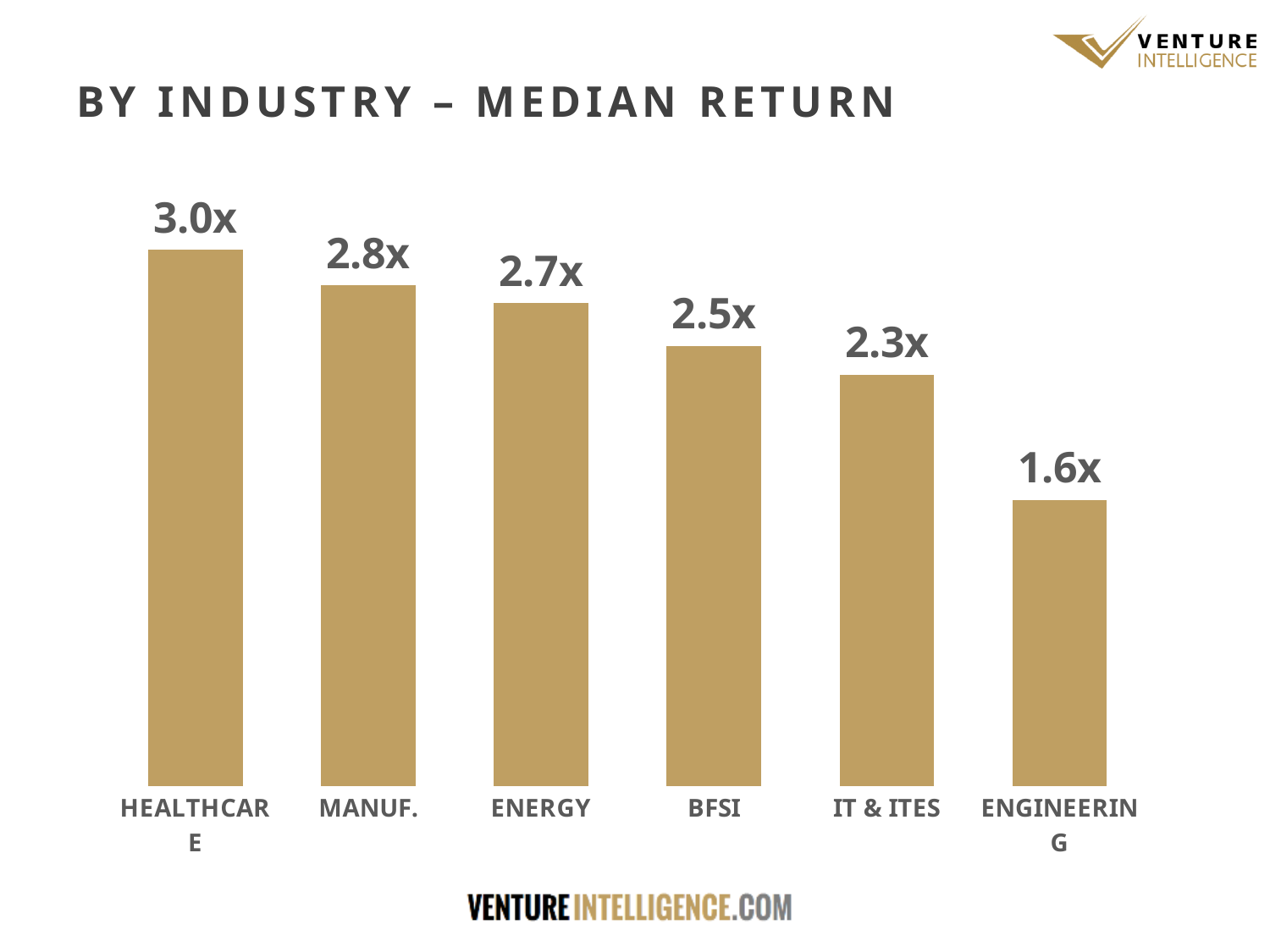
What is the median return for BFSI? 2.5x Which industry has the lowest median return? Engineering Which industry has the highest median return? Healthcare What is the difference between the median return for Manuf. and BFSI? 0.3x What is the median return for Healthcare? 3.0x What is the median return for Energy? 2.7x What is the difference between the median return for Healthcare and Engineering? 1.4x What is the title of the chart? BY INDUSTRY – MEDIAN RETURN How many industries are shown in the chart? 6 What is the median return for IT & ITES? 2.3x What kind of chart is shown on the slide? Bar chart Which has a higher median return, Energy or IT & ITES? Energy